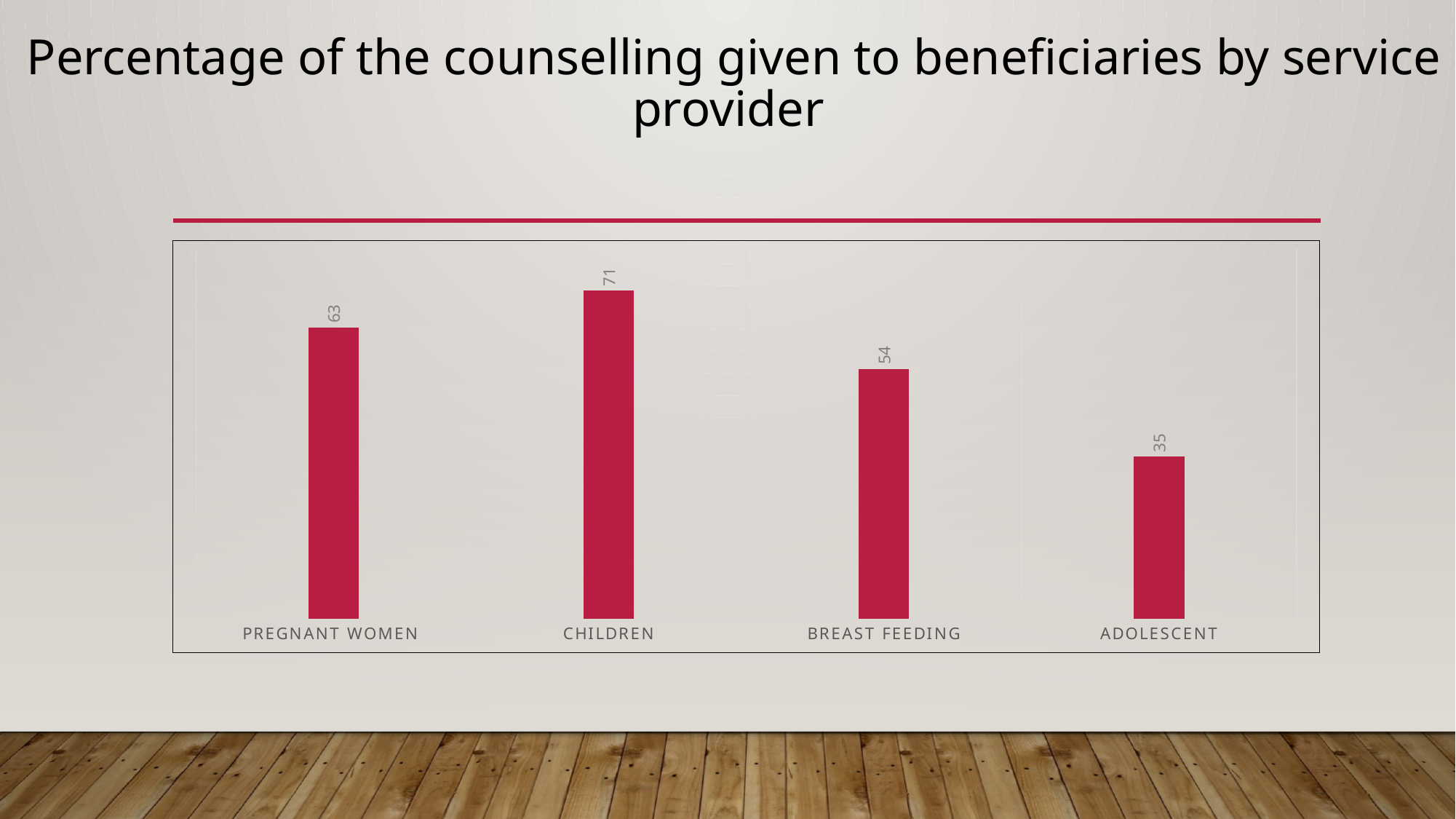
Which category has the highest value? Children How many categories are shown in the chart? 4 What kind of chart is shown on the slide? Bar chart Which is larger, the value for Pregnant Women or the value for Breast Feeding? Pregnant Women What is the value for Adolescent? 35 What is the title of the slide? Percentage of the counselling given to beneficiaries by service provider What is the value for Pregnant Women? 63 What is the difference between the values for Children and Adolescent? 36 What is the value for Breast Feeding? 54 Which category has the lowest value? Adolescent What is the value for Children? 71 What is the difference between the values for Pregnant Women and Breast Feeding? 9